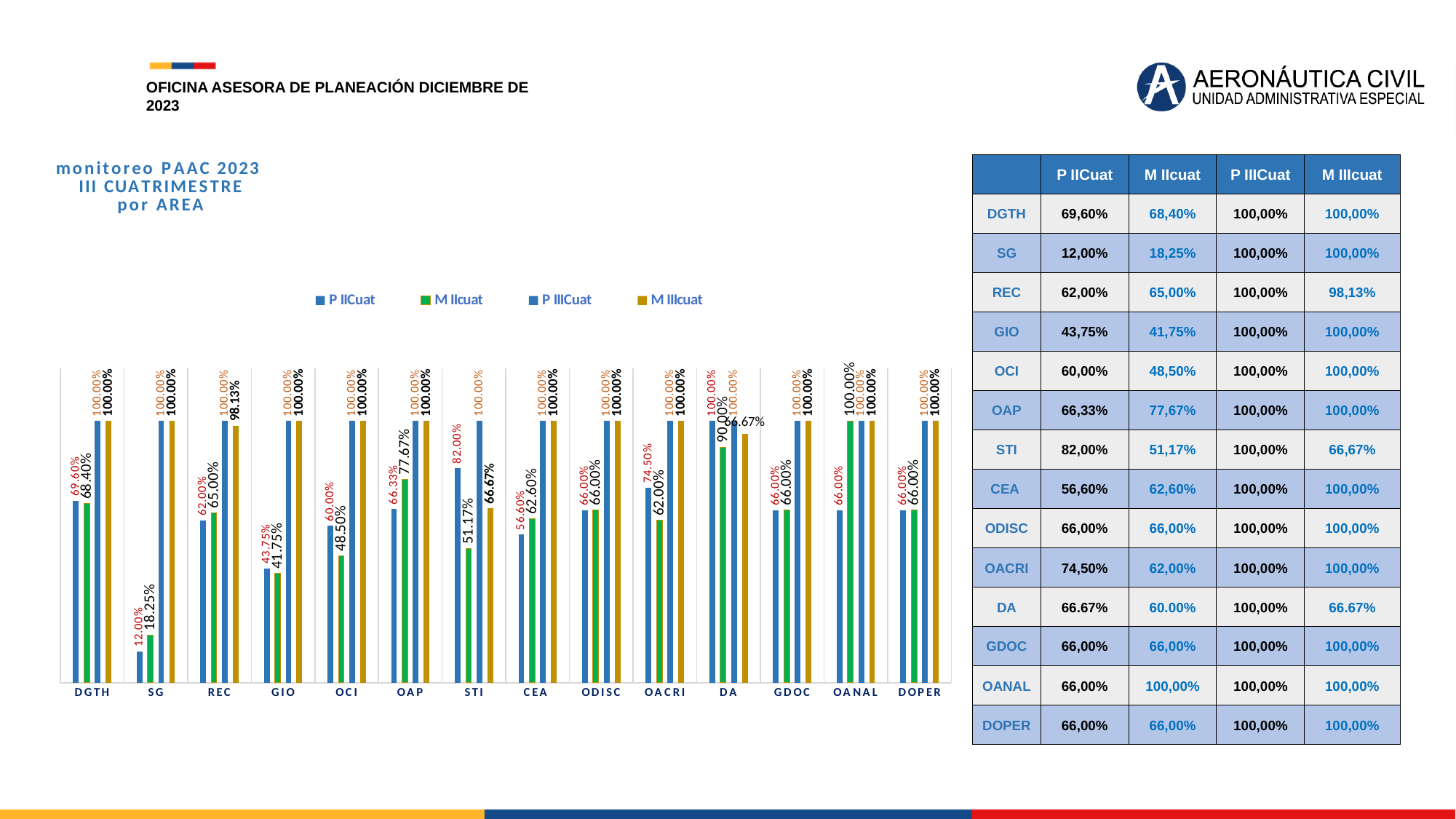
What colour represents the M IIcuat series in the chart legend? green Which area has the highest P IICuat value in the chart? DA What is the M IIIcuat value for REC in the chart? 98.13% What is the difference between the P IICuat and M IIcuat values for DGTH in the chart? 1.20% How many areas (categories) are shown on the x axis of the chart? 14 How many series does the chart legend list? 4 Which area has the lowest P IICuat value in the chart? SG What is the P IICuat value for SG in the chart? 12.00% For OACRI, which is larger in the chart: the P IICuat value or the M IIcuat value? P IICuat What is the M IIIcuat value for STI in the chart? 66.67% What kind of chart is shown on the slide? bar chart What is the M IIcuat value for OAP in the chart? 77.67%